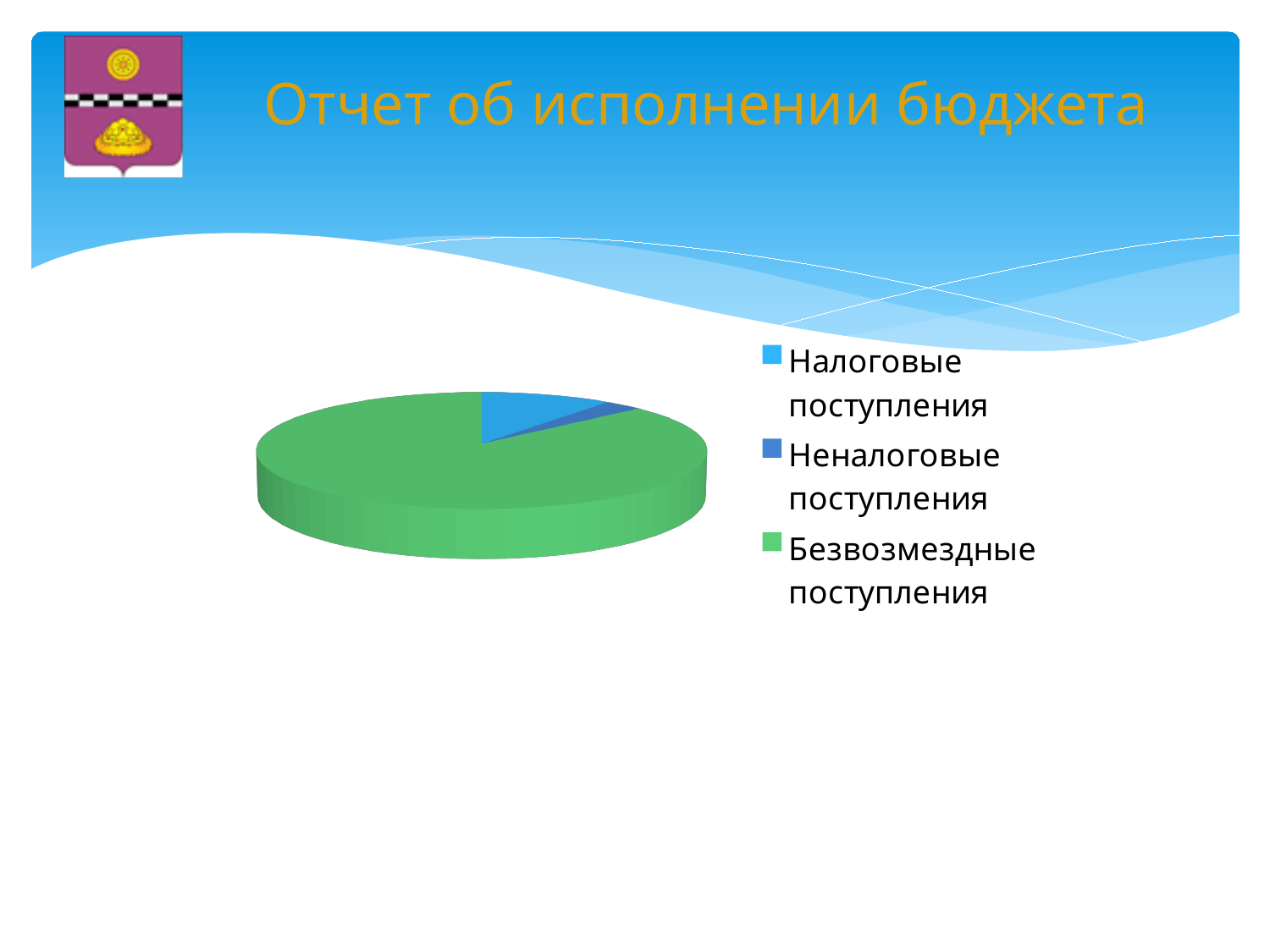
Does the slice for Безвозмездные поступления take up more or less than half of the pie? more What is the title of the slide containing the pie chart? Отчет об исполнении бюджета How many entries does the legend of the pie chart list? 3 Which category has the smallest slice of the pie chart? Неналоговые поступления Which slice is larger: Налоговые поступления or Неналоговые поступления? Налоговые поступления What kind of chart is shown on the slide? pie chart Which category has the largest slice of the pie chart? Безвозмездные поступления Which slice is larger: Безвозмездные поступления or Налоговые поступления? Безвозмездные поступления How many slices does the pie chart have? 3 What colour is the slice for Безвозмездные поступления? green